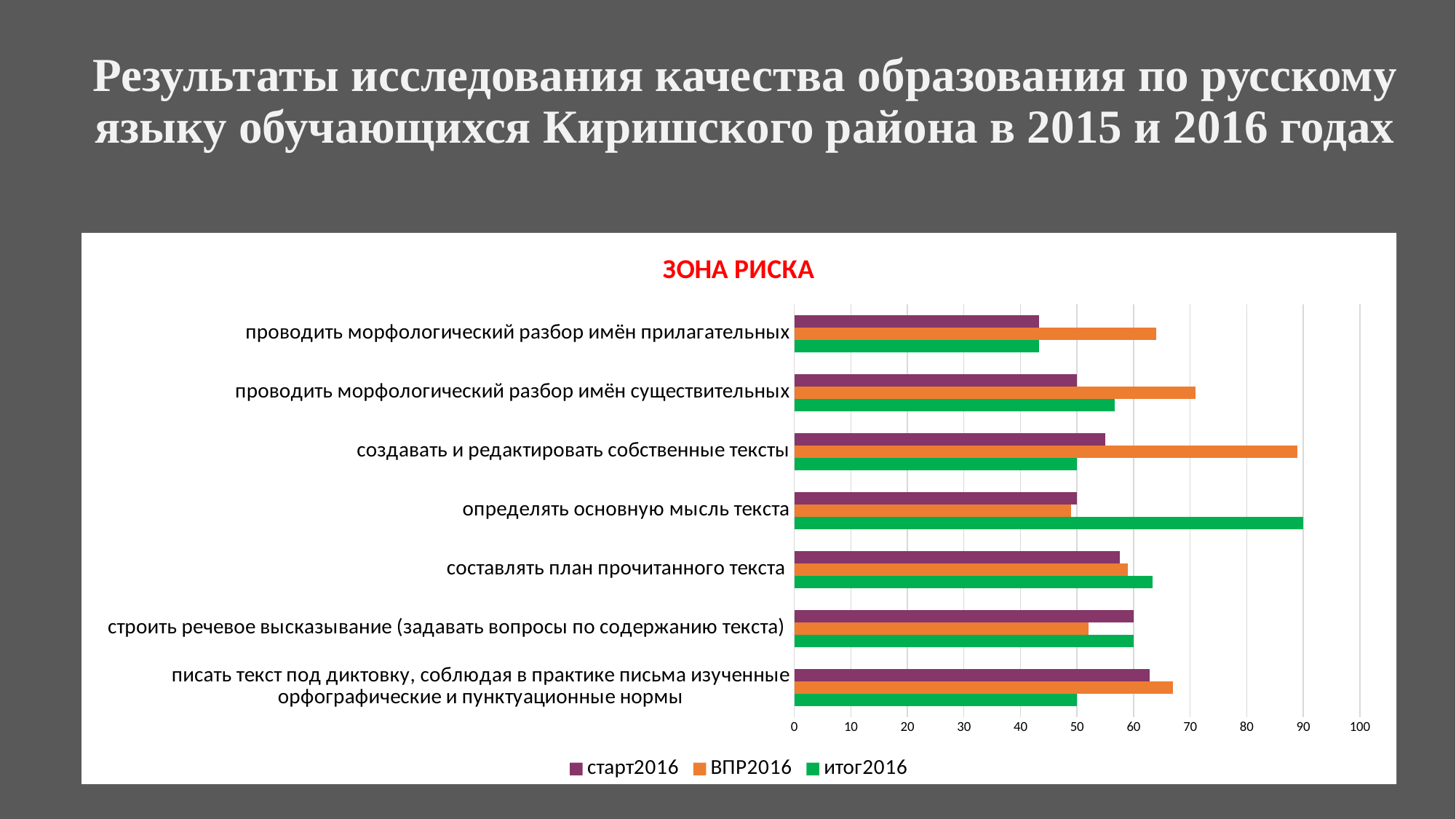
Is the старт2016 value for 'проводить морфологический разбор имён прилагательных' greater or less than 50? less Is the ВПР2016 value for 'создавать и редактировать собственные тексты' greater or less than 80? greater Which series are listed in the legend? старт2016, ВПР2016, итог2016 For 'определять основную мысль текста', which is larger: the итог2016 value or the ВПР2016 value? итог2016 What is the title of the chart? ЗОНА РИСКА Which category has the highest итог2016 value? определять основную мысль текста Is the ВПР2016 value for 'писать текст под диктовку, соблюдая в практике письма изученные орфографические и пунктуационные нормы' greater or less than 60? greater For 'проводить морфологический разбор имён существительных', which is larger: the ВПР2016 value or the старт2016 value? ВПР2016 How many series does the legend list? 3 How many categories are plotted on the chart? 7 What kind of chart is shown on the slide? bar chart Which category has the highest ВПР2016 value? создавать и редактировать собственные тексты